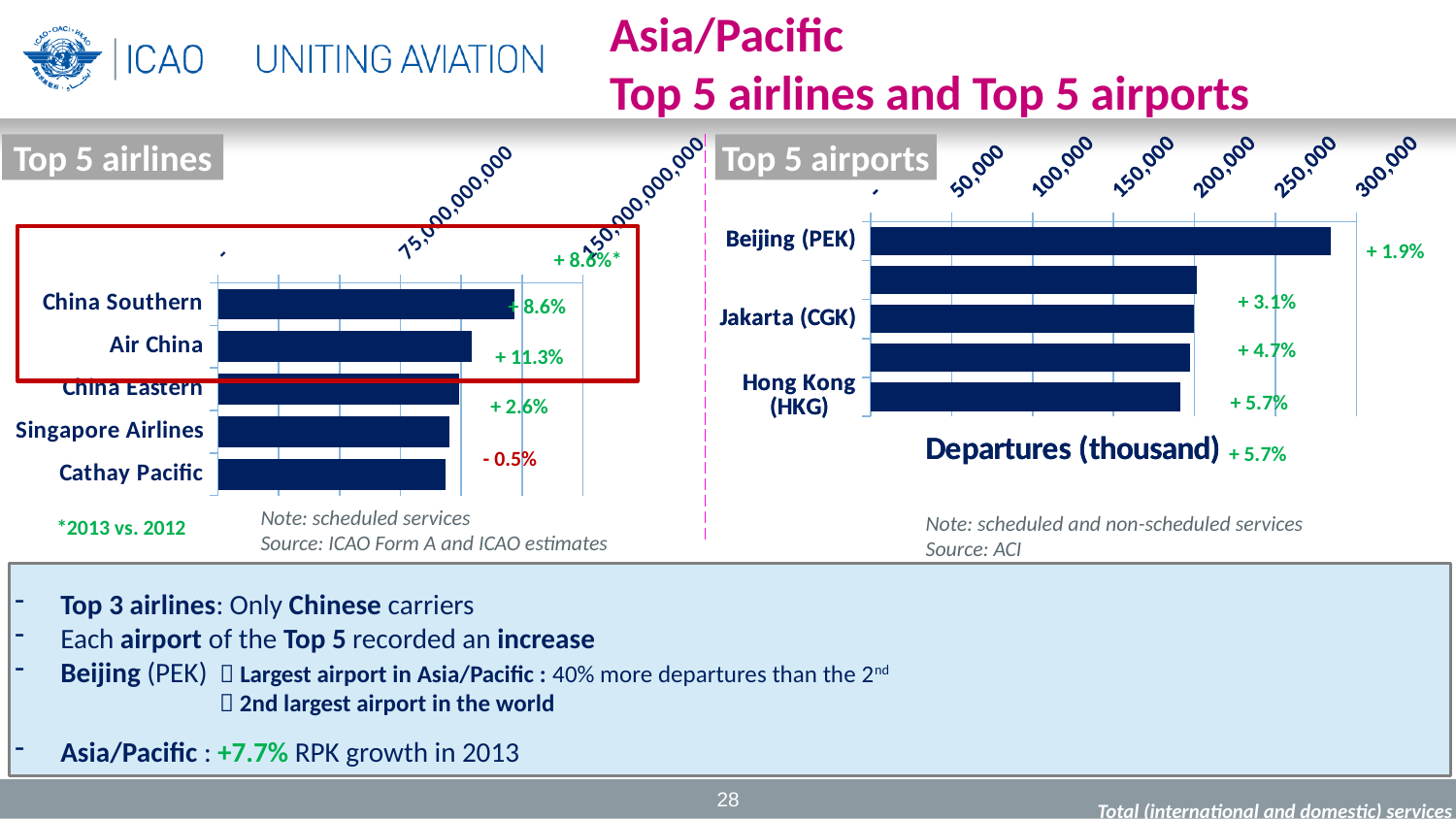
What is the axis title shown on the Top 5 airports chart? Departures (thousand) In the Top 5 airports chart, is the value for Hong Kong (HKG) greater or less than 250,000? less In the Top 5 airports chart, which is larger, the value for Beijing (PEK) or the value for Jakarta (CGK)? Beijing (PEK) In the Top 5 airlines chart, which is larger, the value for Air China or the value for Singapore Airlines? Air China In the Top 5 airlines chart, which airline has the longest bar? China Southern In the Top 5 airlines chart, how many airlines are shown? 5 In the Top 5 airports chart, which airport has the most departures? Beijing (PEK) In the Top 5 airlines chart, is the value for China Southern greater or less than 75,000,000,000? greater What kind of chart is the Top 5 airlines chart? bar chart In the Top 5 airports chart, is the value for Beijing (PEK) greater or less than 250,000? greater In the Top 5 airlines chart, which is larger, the value for China Southern or the value for Air China? China Southern In the Top 5 airports chart, how many bars are plotted? 5